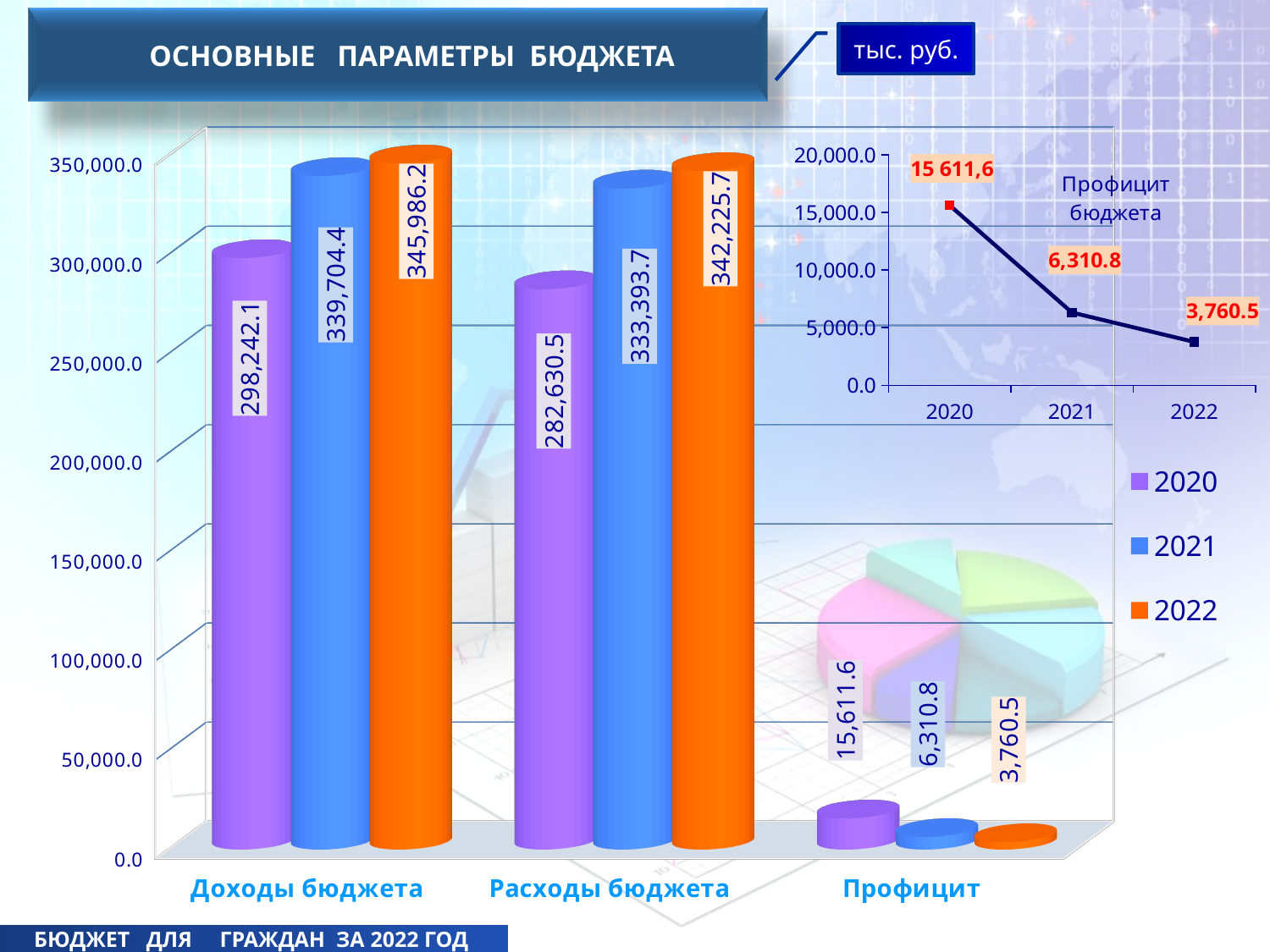
In the bar chart, which is larger: Расходы бюджета in 2021 or Доходы бюджета in 2020? Расходы бюджета in 2021 In the bar chart, what is the value for Профицит in 2021? 6,310.8 In the bar chart, what is the value for Расходы бюджета in 2020? 282,630.5 What kind of chart is the small chart titled Профицит бюджета in the upper right? line chart In the bar chart, which category has the lowest values overall? Профицит How many series does the legend of the bar chart list? 3 In the bar chart, what is the value for Доходы бюджета in 2022? 345,986.2 In the bar chart, what is the difference between Доходы бюджета and Расходы бюджета in 2022? 3,760.5 In the bar chart, which year has the highest value for Доходы бюджета? 2022 How many categories are shown on the x axis of the bar chart? 3 In the bar chart, what is the difference between Доходы бюджета in 2021 and in 2020? 41,462.3 In the line chart titled Профицит бюджета, do the values rise or fall from 2020 to 2022? fall